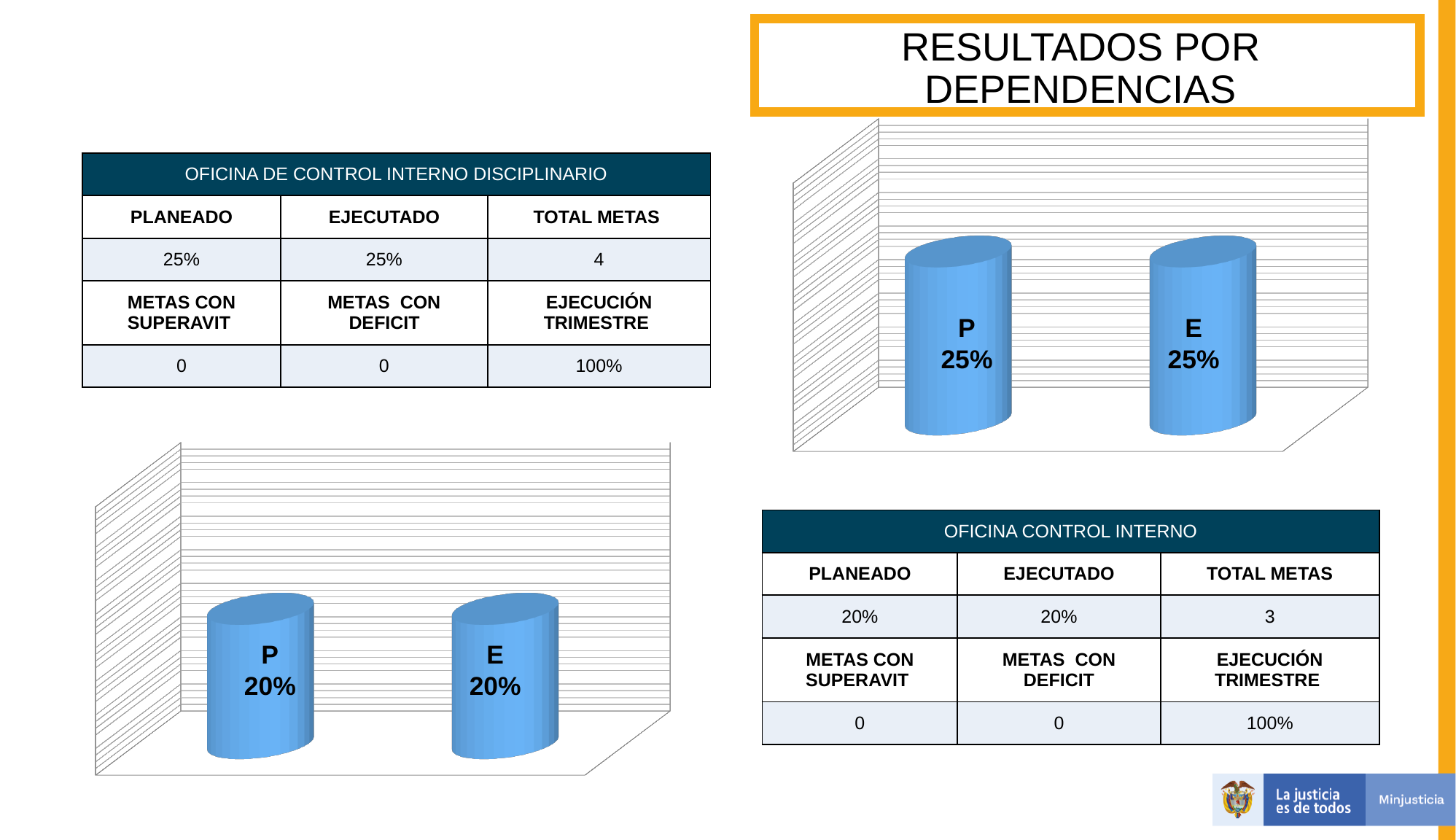
In the chart at the bottom left of the slide, what is the value labelled on the bar P? 20% What colour are the bars in the chart at the top right of the slide? Blue In the chart at the top right of the slide, what is the value labelled on the bar E? 25% In the chart at the top right of the slide, what is the difference between the values of P and E? 0% What kind of chart is shown at the top right of the slide? Bar chart In the chart at the top right of the slide, what is the value labelled on the bar P? 25% In the chart at the bottom left of the slide, what is the difference between the values of P and E? 0% In the chart at the bottom left of the slide, what are the labels of the two bars? P and E How many bars are plotted in the chart at the top right of the slide? 2 In the chart at the bottom left of the slide, what is the value labelled on the bar E? 20% How many bars are plotted in the chart at the bottom left of the slide? 2 What kind of chart is shown at the bottom left of the slide? Bar chart